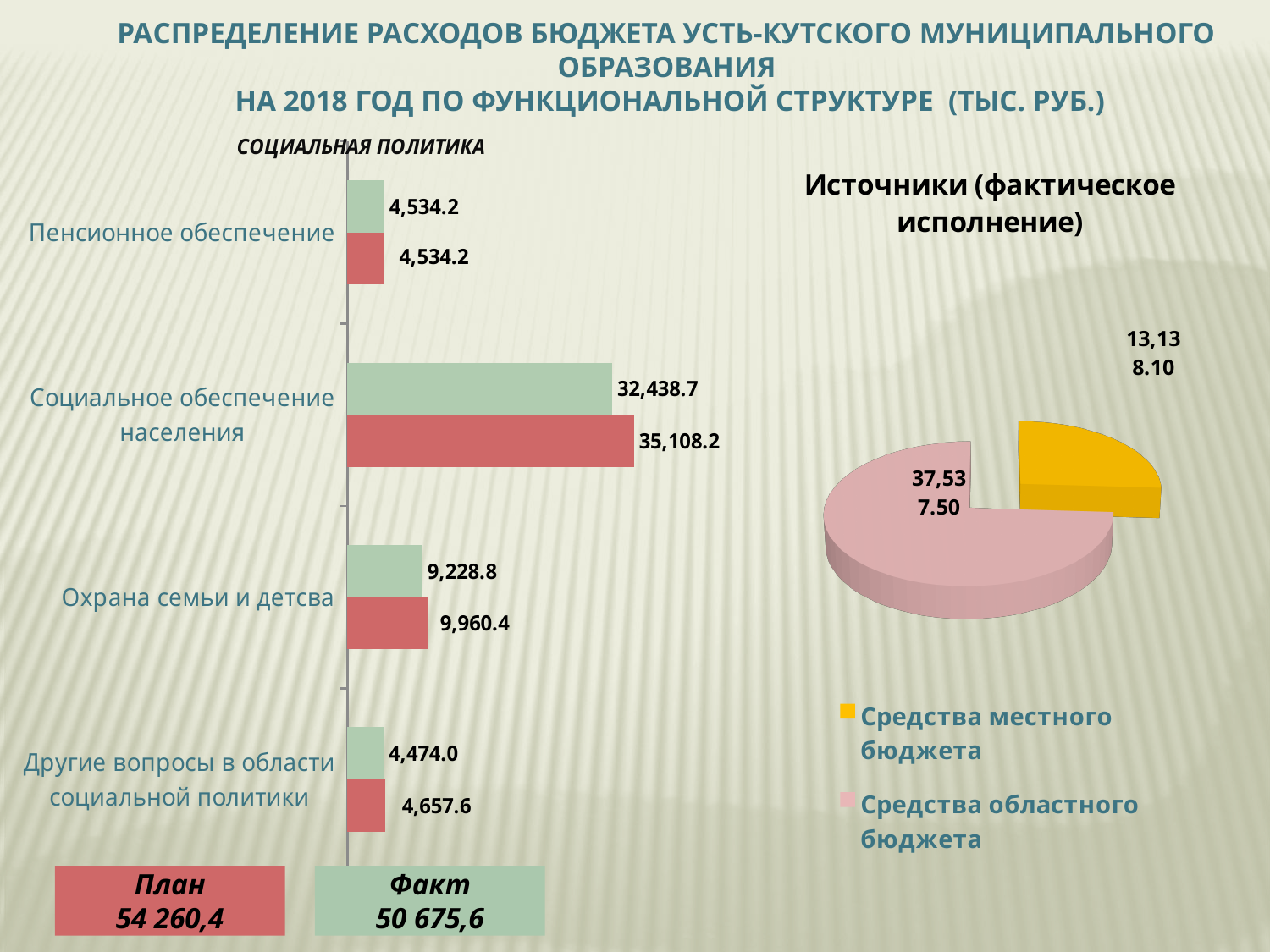
In the bar chart 'Социальная политика', which is larger for Другие вопросы в области социальной политики: План or Факт? План In the bar chart 'Социальная политика', what is the difference between the План and Факт values for Социальное обеспечение населения? 2,669.5 What type of chart is 'Источники (фактическое исполнение)'? Pie chart In the bar chart 'Социальная политика', what is the difference between the План and Факт values for Охрана семьи и детсва? 731.6 In the bar chart 'Социальная политика', what is the План value for Социальное обеспечение населения? 35,108.2 In the bar chart 'Социальная политика', which category has the lowest Факт value? Другие вопросы в области социальной политики In the bar chart 'Социальная политика', which category has the highest Факт value? Социальное обеспечение населения In the bar chart 'Социальная политика', what is the Факт value for Другие вопросы в области социальной политики? 4,474.0 In the bar chart 'Социальная политика', what is the Факт value for Охрана семьи и детсва? 9,228.8 How many categories are shown in the bar chart 'Социальная политика'? 4 In the pie chart 'Источники (фактическое исполнение)', which source has the larger slice? Средства областного бюджета In the bar chart 'Социальная политика', what is the План value for Пенсионное обеспечение? 4,534.2